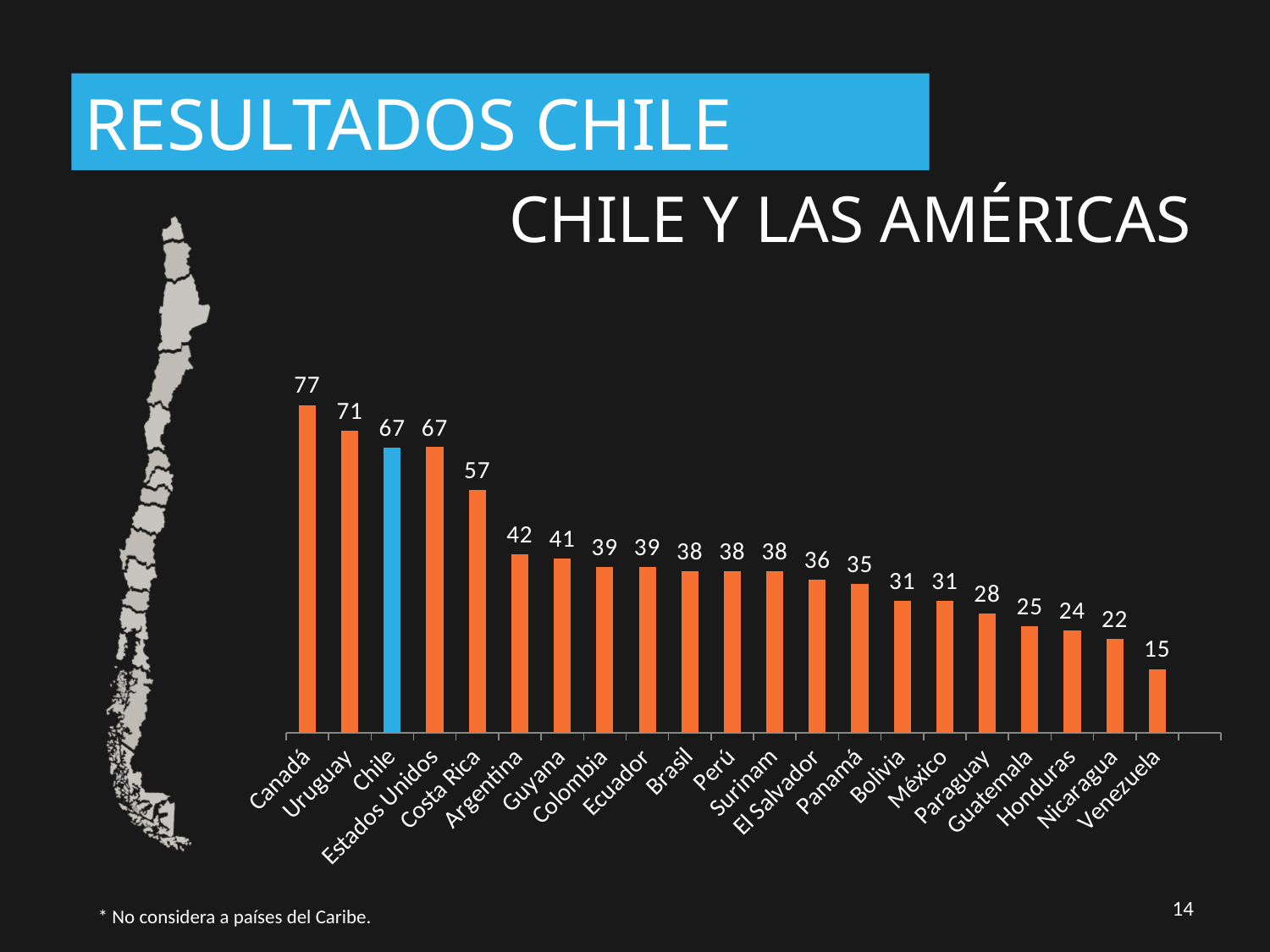
Do the values rise or fall from left to right along the x axis? Fall What kind of chart is shown on the slide? Bar chart Which country's bar is coloured blue instead of orange? Chile What is the value for Costa Rica? 57 What is the value for Canadá? 77 Which country has the highest value? Canadá What is the value for Venezuela? 15 What is the value for Chile? 67 Which country has the lowest value? Venezuela Which has a larger value, Uruguay or Argentina? Uruguay What is the difference between the values for Canadá and Chile? 10 How many countries are shown in the chart? 21